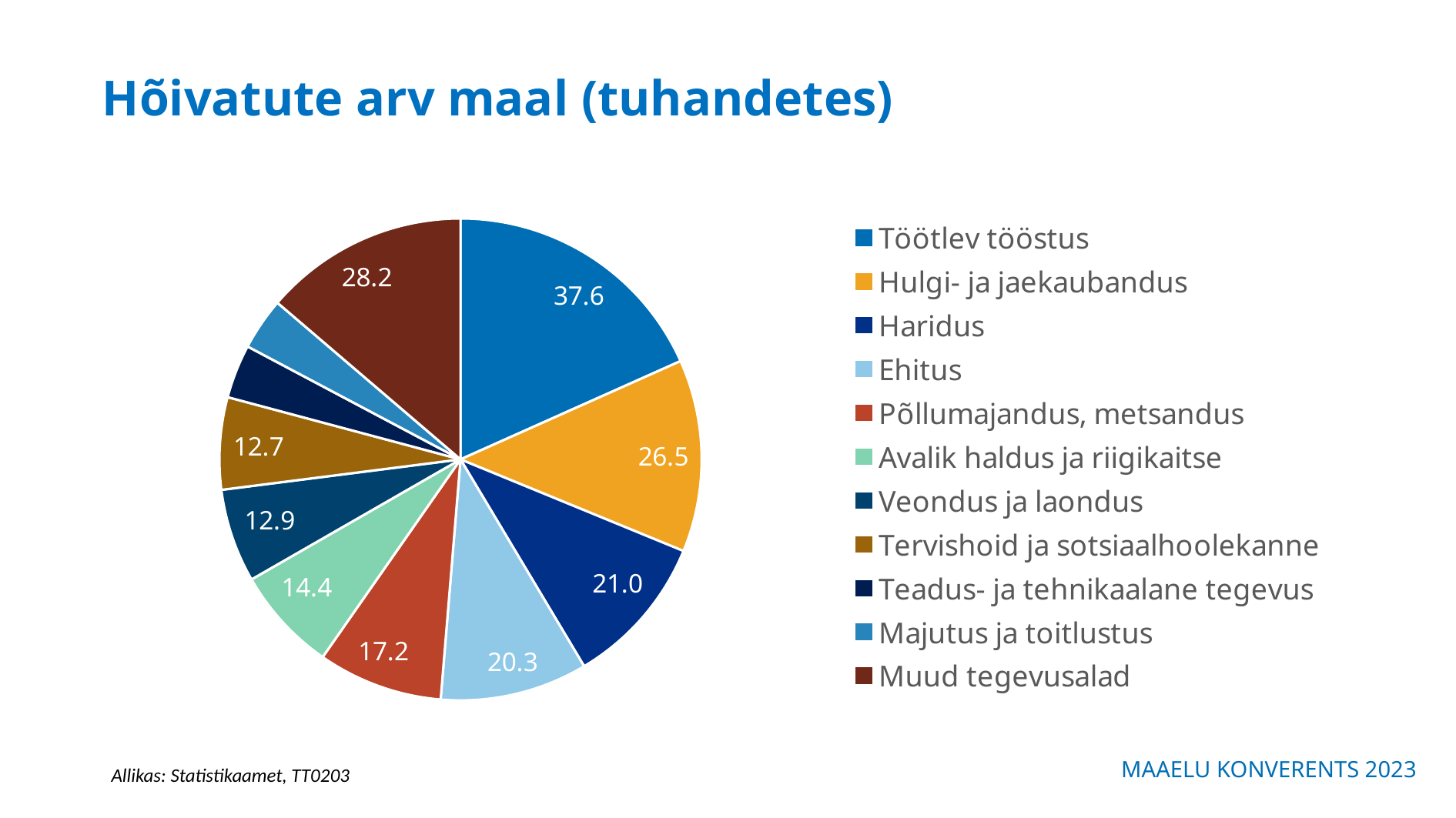
Which category has the largest slice of the pie? Töötlev tööstus What is the difference between the values for Muud tegevusalad and Haridus? 7.2 How many categories does the legend list? 11 What kind of chart is shown on the slide? Pie chart What is the value for Muud tegevusalad? 28.2 What is the value for Töötlev tööstus? 37.6 Which is larger, the value for Põllumajandus, metsandus or the value for Veondus ja laondus? Põllumajandus, metsandus What is the value for Hulgi- ja jaekaubandus? 26.5 What is the value for Avalik haldus ja riigikaitse? 14.4 What is the difference between the values for Töötlev tööstus and Hulgi- ja jaekaubandus? 11.1 What is the value for Ehitus? 20.3 What is the title of the chart? Hõivatute arv maal (tuhandetes)